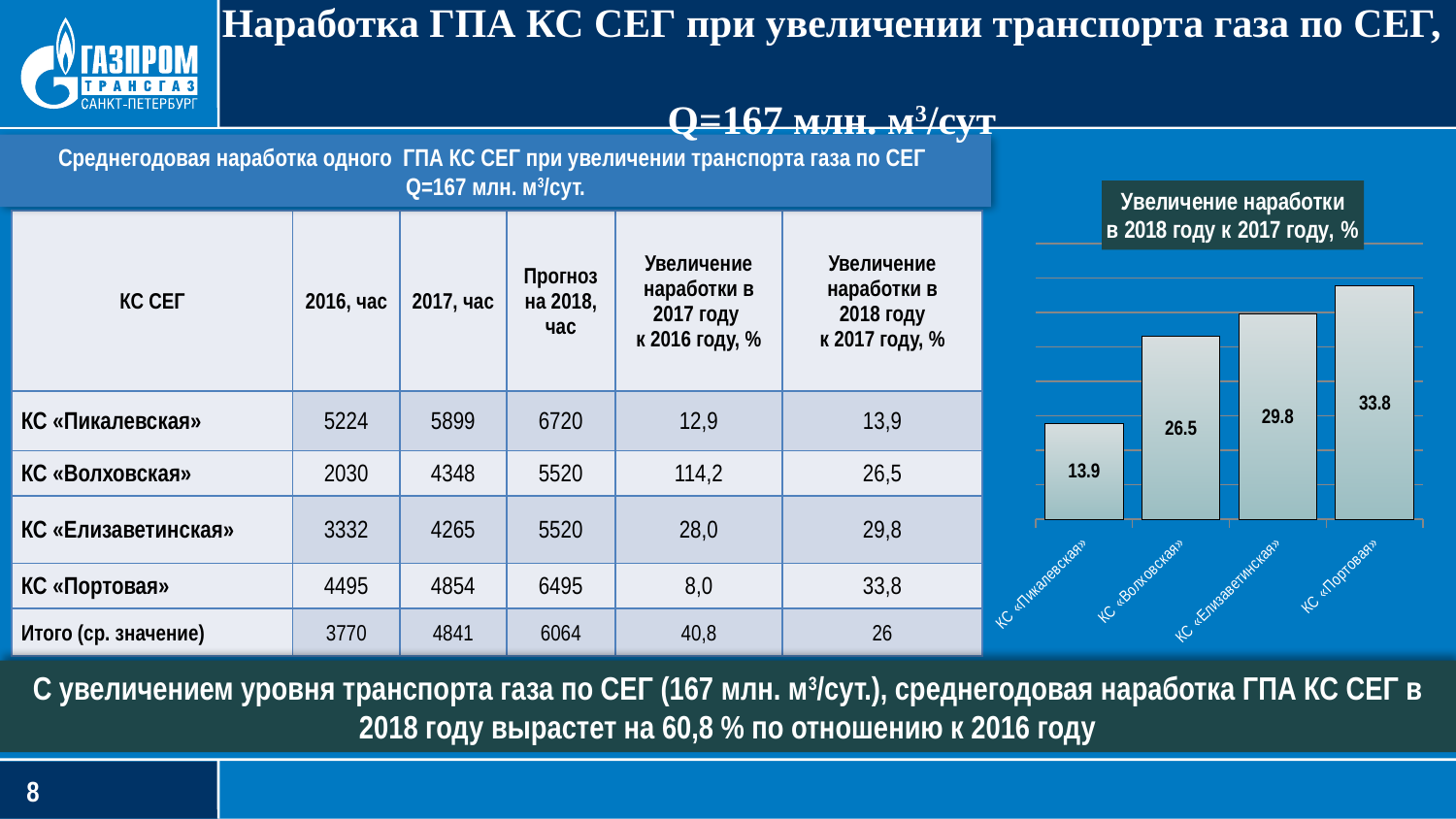
What is the difference between the values for КС «Елизаветинская» and КС «Волховская»? 3.3 Do the values rise or fall from left to right across the categories? Rise Which category has the highest value in the chart? КС «Портовая» What is the value for КС «Портовая» in the chart? 33.8 How many categories are shown in the chart? 4 What is the value for КС «Пикалевская» in the chart? 13.9 What is the value for КС «Елизаветинская» in the chart? 29.8 Which category has the lowest value in the chart? КС «Пикалевская» What is the difference between the values for КС «Портовая» and КС «Пикалевская»? 19.9 Which is larger: the value for КС «Волховская» or КС «Елизаветинская»? КС «Елизаветинская» What is the value for КС «Волховская» in the chart? 26.5 What kind of chart is shown on the slide? Bar chart